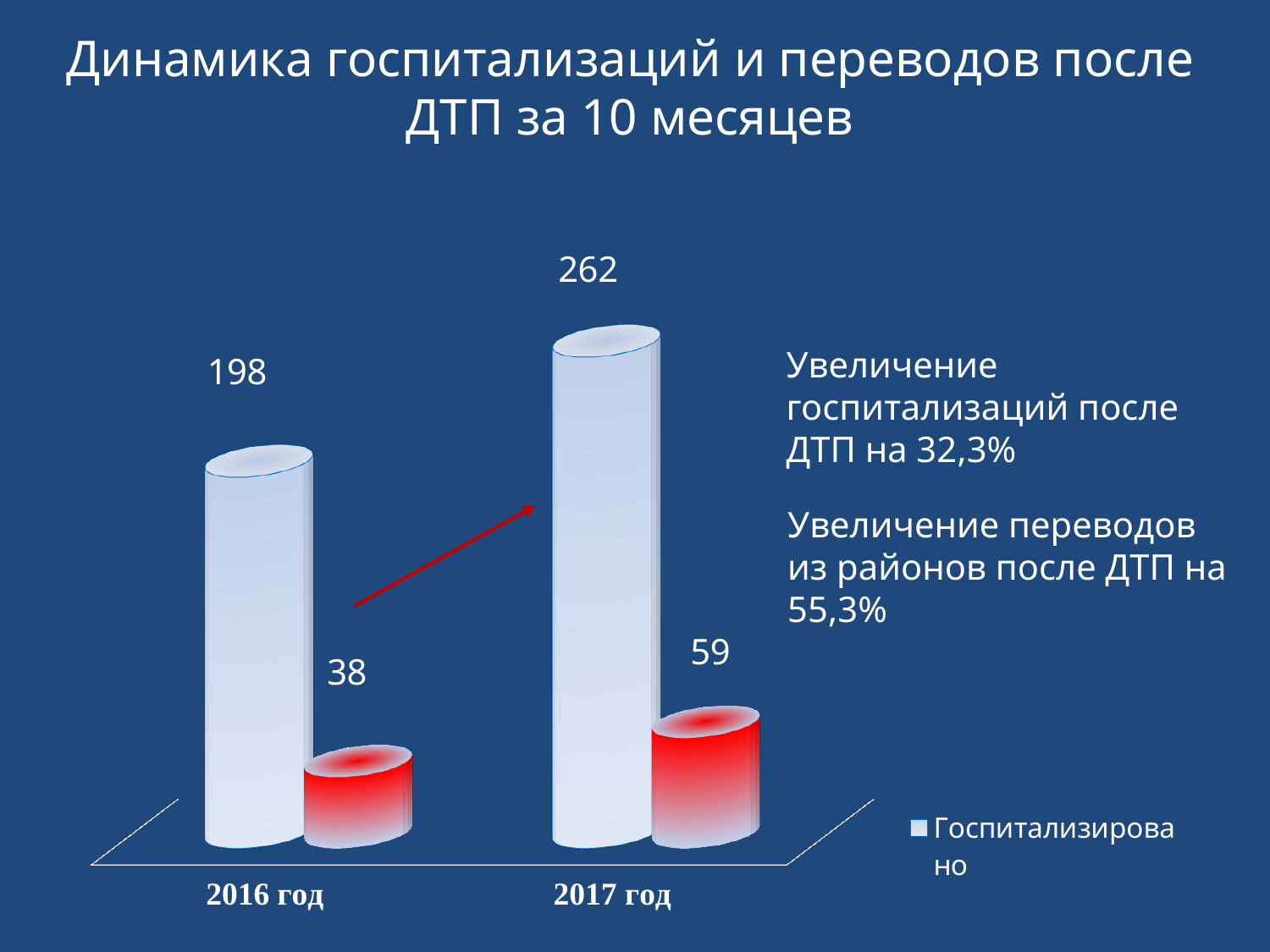
What is the value of the red series for 2016 год? 38 What is the value of the Госпитализировано series for 2017 год? 262 How many categories are shown on the x axis? 2 What is the value of the Госпитализировано series for 2016 год? 198 What is the title of the slide containing the chart? Динамика госпитализаций и переводов после ДТП за 10 месяцев Which year has the higher Госпитализировано value, 2016 год or 2017 год? 2017 год What is the value of the red series for 2017 год? 59 Which category has the lowest value of the red series? 2016 год Do the Госпитализировано values rise or fall from 2016 год to 2017 год? Rise By how much did the Госпитализировано value increase from 2016 год to 2017 год? 64 What kind of chart is shown on the slide? Bar chart What is the difference between the red series values for 2017 год and 2016 год? 21